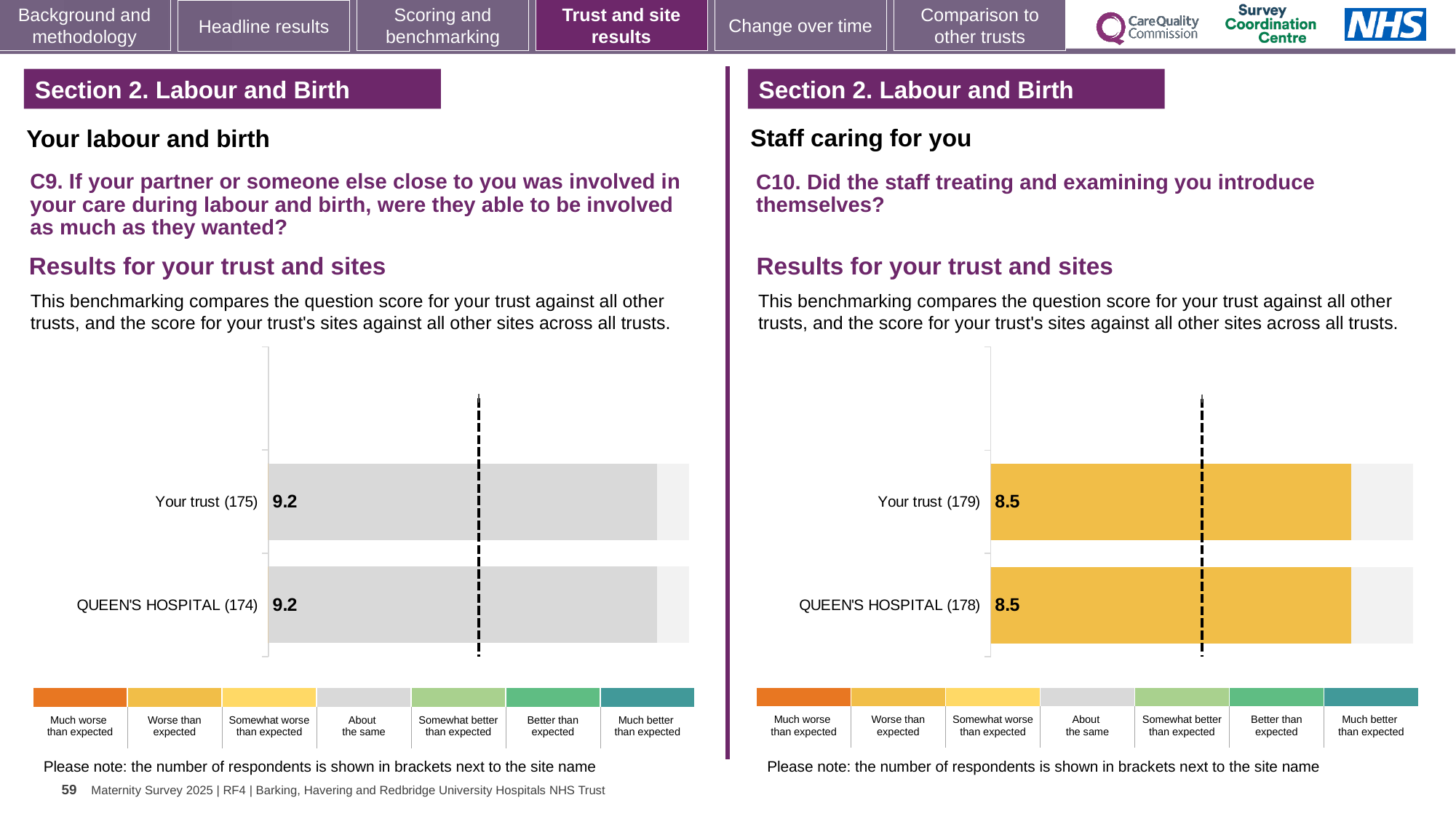
How many respondents are shown in brackets for Your trust in the C10 chart on the right? 179 What kind of chart is used for the C9 results on the left? Bar chart How many bars are plotted in the C10 chart on the right? 2 In the C10 chart on the right, what is the score for QUEEN'S HOSPITAL? 8.5 In the C10 chart on the right, what is the score for Your trust? 8.5 How many bars are plotted in the C9 chart on the left? 2 In the C10 chart on the right, what is the difference between the score for Your trust and the score for QUEEN'S HOSPITAL? 0.0 How many categories does the colour legend below the C9 chart on the left list? 7 In the C9 chart on the left, what is the difference between the score for Your trust and the score for QUEEN'S HOSPITAL? 0.0 In the C9 chart on the left, what is the score for Your trust? 9.2 In the C9 chart on the left, what is the score for QUEEN'S HOSPITAL? 9.2 In the C10 chart on the right, which legend category does the colour of the bars correspond to? Worse than expected